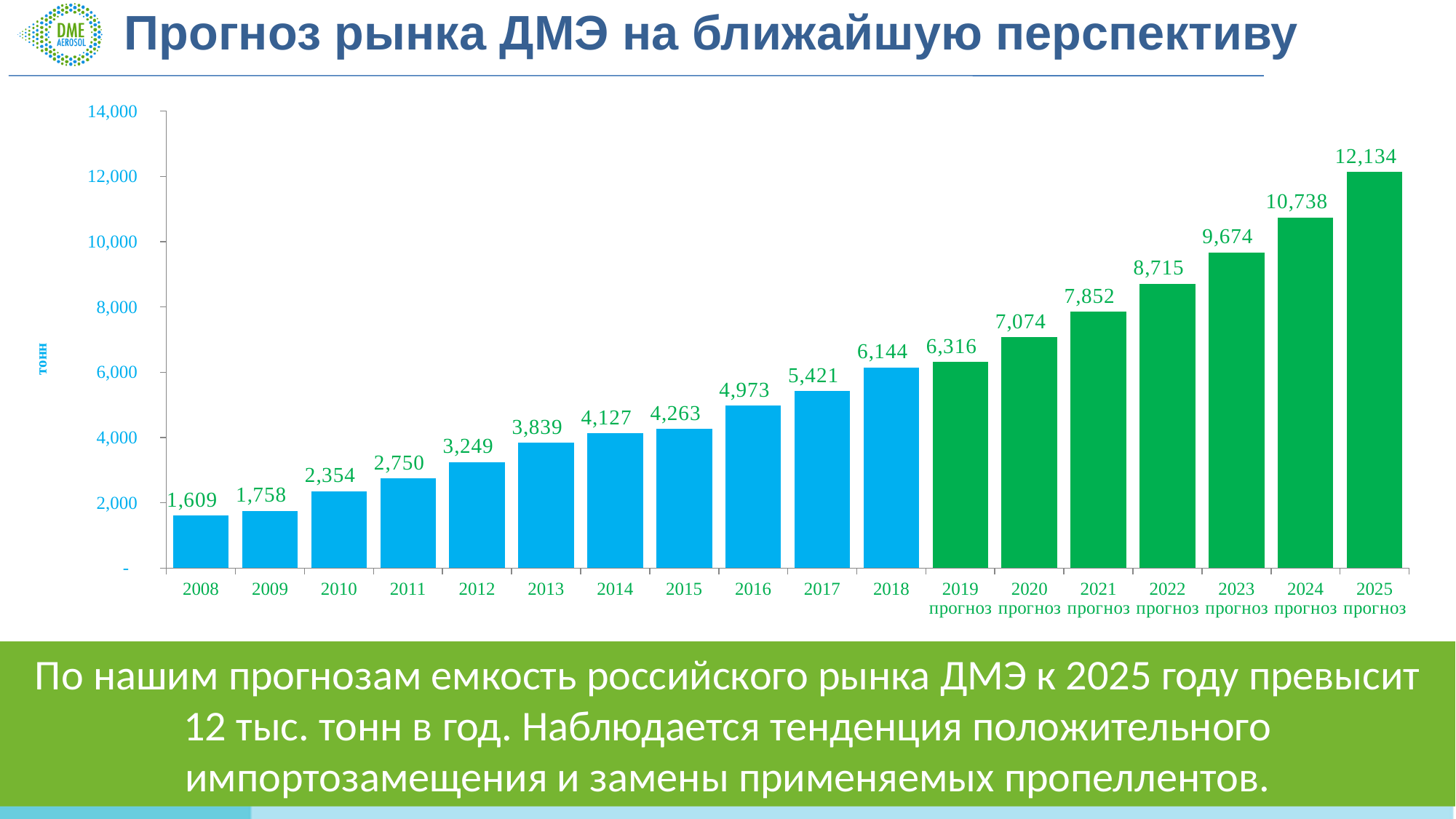
How many years are shown on the x axis? 18 Which is larger, the value for 2016 or the value for 2019? 2019 Is the value for 2023 greater or less than 10,000? less What is the difference between the values for 2025 and 2024? 1,396 What is the difference between the values for 2018 and 2008? 4,535 Which year has the lowest value? 2008 What kind of chart is shown? bar chart What is the forecast value for 2025? 12,134 Do the values rise or fall from 2008 to 2025? rise Which year has the highest value? 2025 What is the value for 2012? 3,249 What is the value for 2018? 6,144